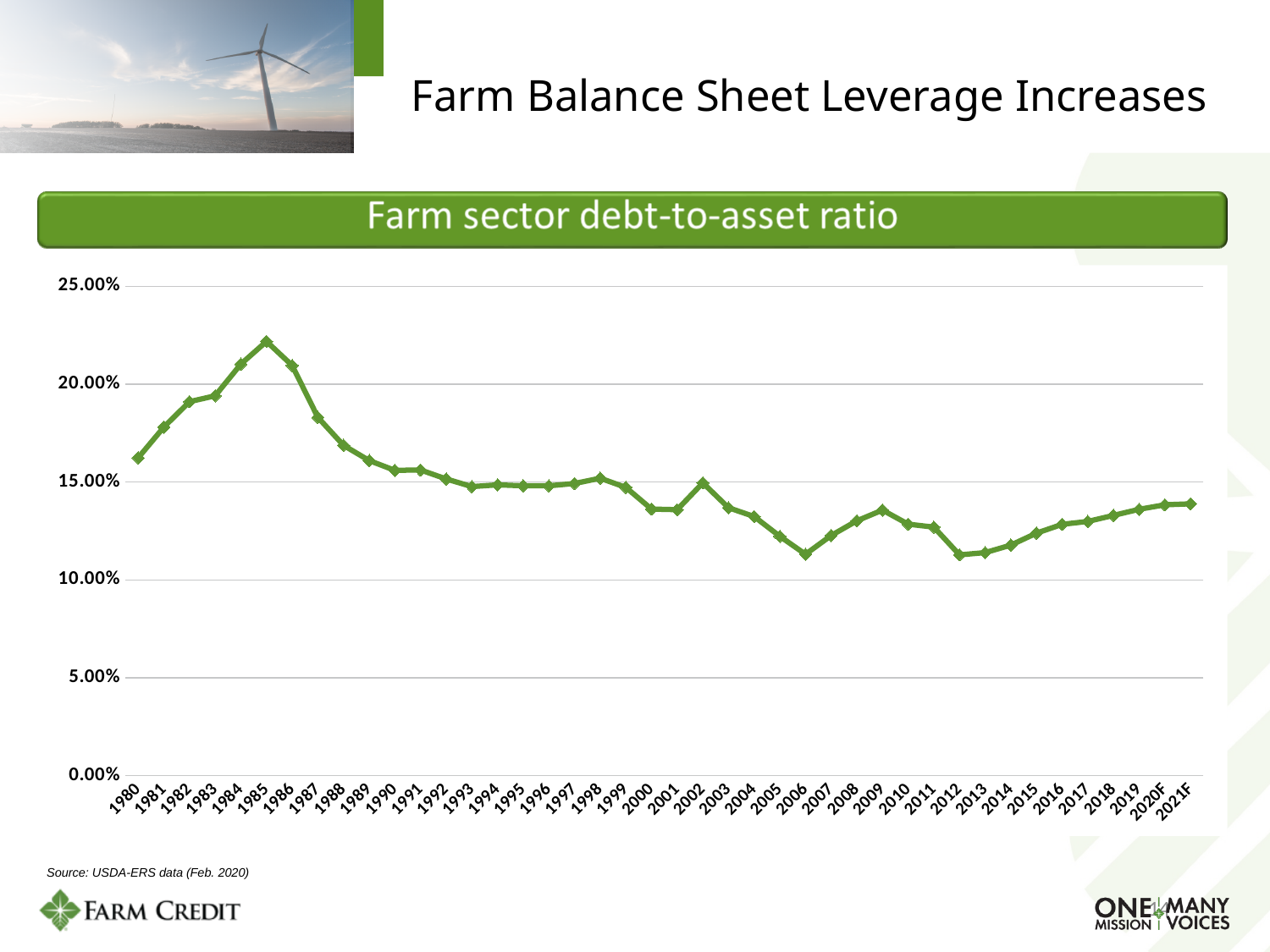
Does the debt-to-asset ratio rise or fall from 1980 to 1985? rise Is the value for 2006 greater or less than 15.00%? less Which year has the highest farm sector debt-to-asset ratio? 1985 Is the value for 2021F greater or less than 15.00%? less Which is larger, the value for 1980 or the value for 2021F? 1980 What kind of chart is shown on the slide? Line chart Which is larger, the value for 2002 or the value for 2001? 2002 What is the title of the chart? Farm sector debt-to-asset ratio Is the value for 1985 greater or less than 20.00%? greater Does the debt-to-asset ratio rise or fall from 2012 to 2021F? rise